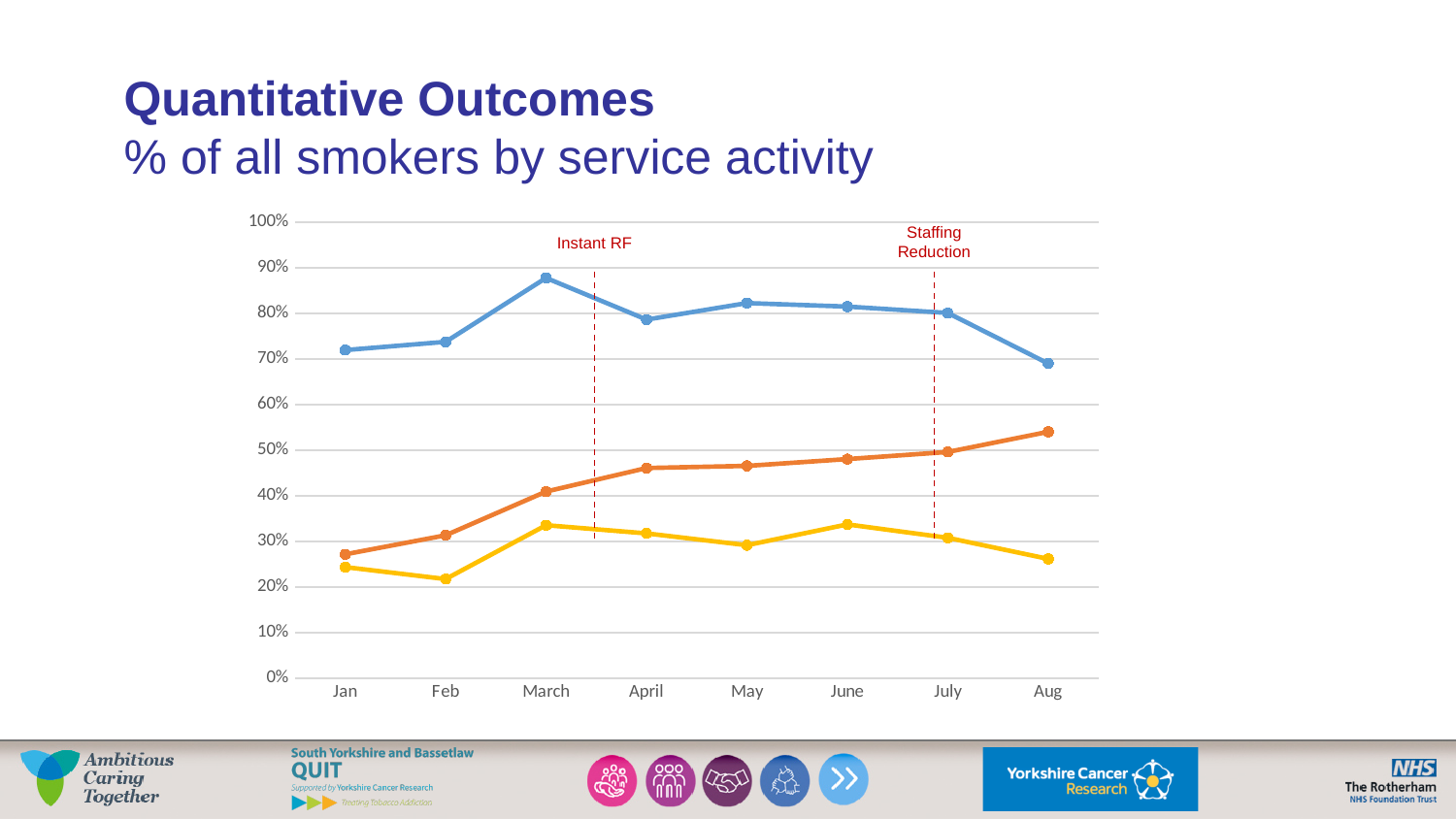
Is the value of the blue line in Aug greater or less than 80%? less How many months are shown along the x axis of the chart? 8 In which month does the blue line reach its highest value? March Does the orange line generally rise or fall from Jan to Aug? rise Is the value of the orange line in Aug greater or less than 50%? greater Which line has the higher value in Jan, the blue line or the orange line? the blue line What kind of chart is shown on the slide? line chart In which month does the orange line reach its highest value? Aug How many lines are plotted on the chart? 3 Is the value of the blue line in March greater or less than 80%? greater In which month is the orange line at its lowest value? Jan